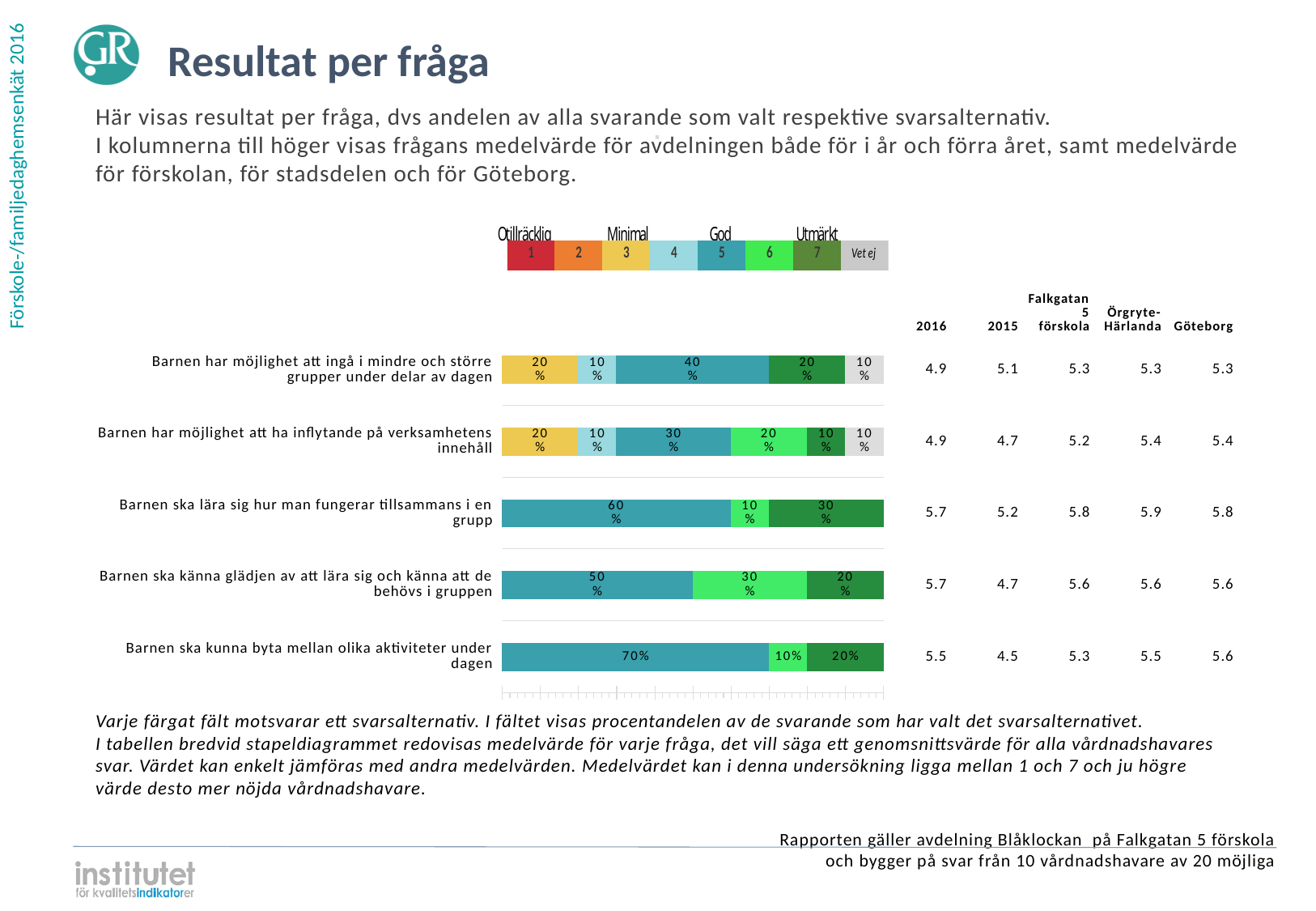
How many questions (categories) are shown in the bar chart? 5 What is the Göteborg mean value for 'Barnen ska kunna byta mellan olika aktiviteter under dagen'? 5.6 What is the 2016 mean value for 'Barnen ska lära sig hur man fungerar tillsammans i en grupp'? 5.7 Which question has the largest single segment in its bar? Barnen ska kunna byta mellan olika aktiviteter under dagen Which is larger: the alternative 6 (bright green) share for 'Barnen ska känna glädjen av att lära sig och känna att de behövs i gruppen' or for 'Barnen ska lära sig hur man fungerar tillsammans i en grupp'? Barnen ska känna glädjen av att lära sig och känna att de behövs i gruppen What is the difference between the alternative 5 share for 'Barnen ska kunna byta mellan olika aktiviteter under dagen' (70%) and for 'Barnen ska känna glädjen av att lära sig och känna att de behövs i gruppen' (50%)? 20% What percentage chose alternative 7 (dark green) for 'Barnen ska lära sig hur man fungerar tillsammans i en grupp'? 30% What is the combined share of alternatives 6 and 7 for 'Barnen har möjlighet att ha inflytande på verksamhetens innehåll'? 30% What percentage of respondents chose alternative 5 (God, teal) for 'Barnen ska kunna byta mellan olika aktiviteter under dagen'? 70% How many response alternatives does the legend above the chart list? 8 What share of respondents answered 'Vet ej' for 'Barnen har möjlighet att ingå i mindre och större grupper under delar av dagen'? 10% What kind of chart is used to show the results per question? Stacked bar chart